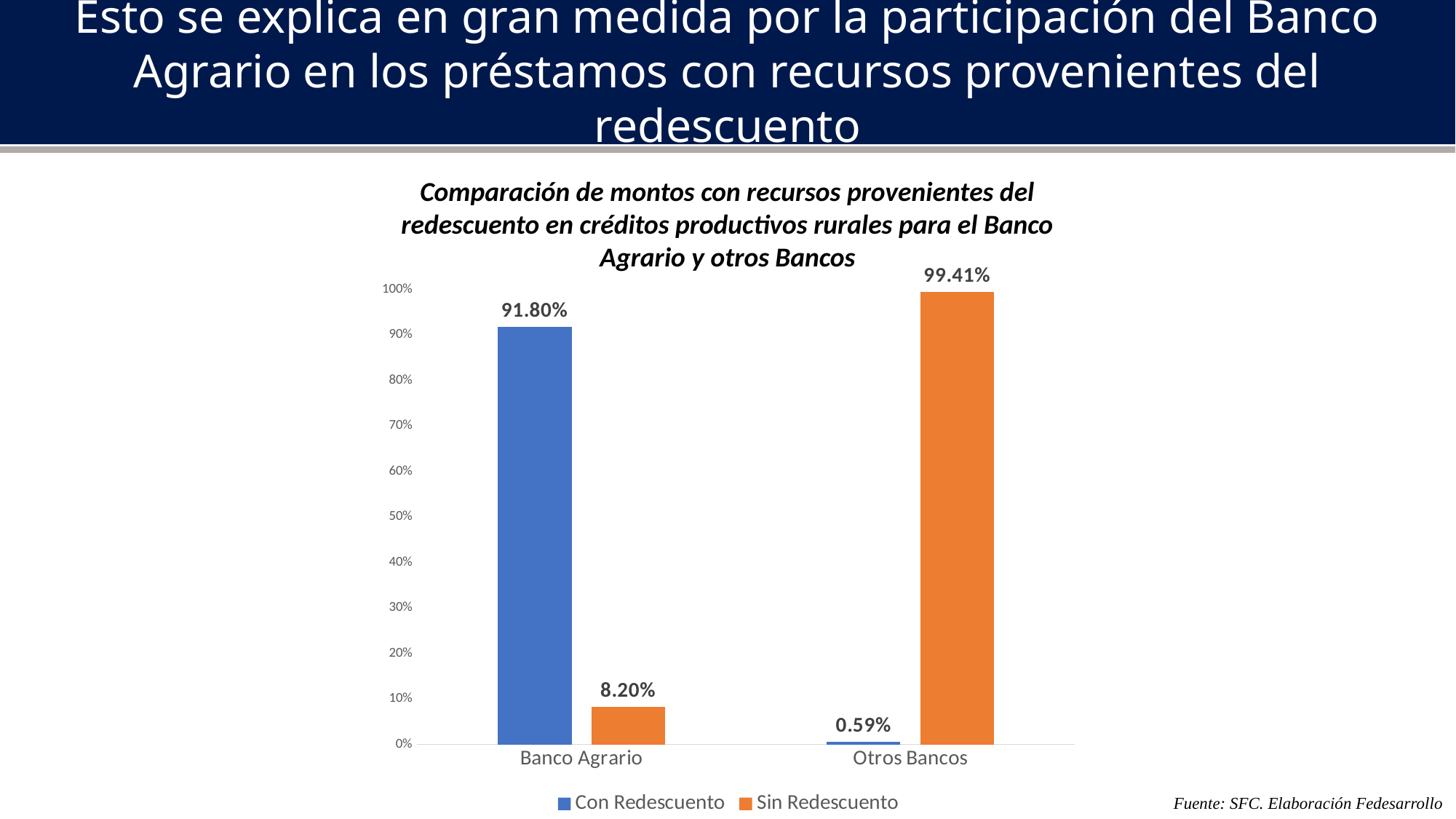
How many series does the legend list? 2 How many categories are shown on the x axis? 2 What is the value for Con Redescuento for Banco Agrario? 91.80% What is the value for Sin Redescuento for Banco Agrario? 8.20% Which is larger for Otros Bancos: Con Redescuento or Sin Redescuento? Sin Redescuento What is the value for Con Redescuento for Otros Bancos? 0.59% What kind of chart is shown on the slide? Bar chart Which category has the highest Con Redescuento value? Banco Agrario What is the value for Sin Redescuento for Otros Bancos? 99.41% Which category has the lowest Sin Redescuento value? Banco Agrario Is the Con Redescuento value for Banco Agrario greater or less than 90%? greater What is the difference between the Con Redescuento and Sin Redescuento values for Banco Agrario? 83.60%